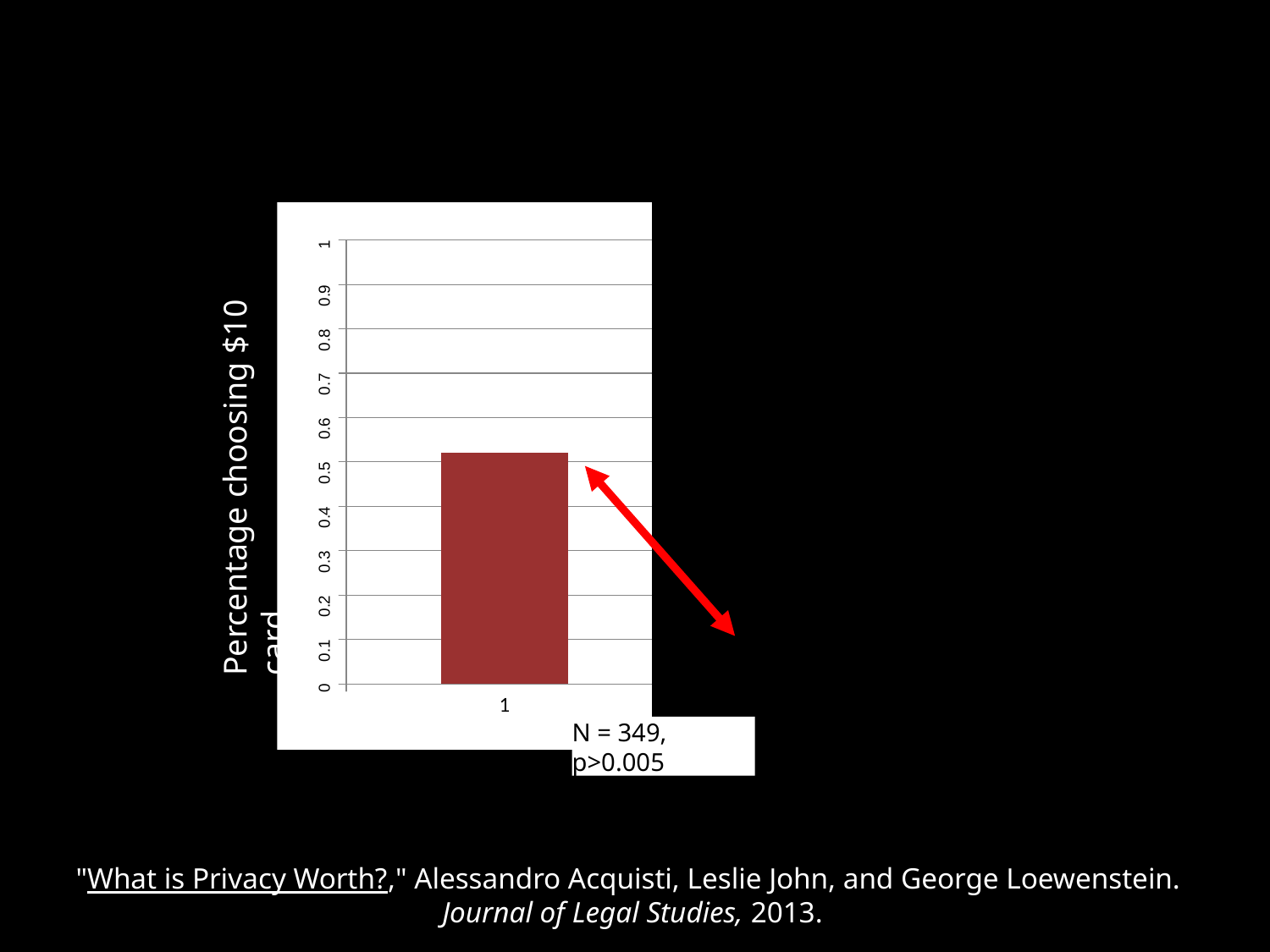
What kind of chart is shown on the slide? bar chart What is the label of the vertical axis of the chart? Percentage choosing $10 card Is the value of the bar for category 1 greater or less than 0.6? less Is the value of the bar for category 1 greater or less than 0.7? less What is the category label shown under the bar on the x axis? 1 How many bars are plotted in the chart? 1 Is the value of the bar for category 1 greater or less than 0.4? greater